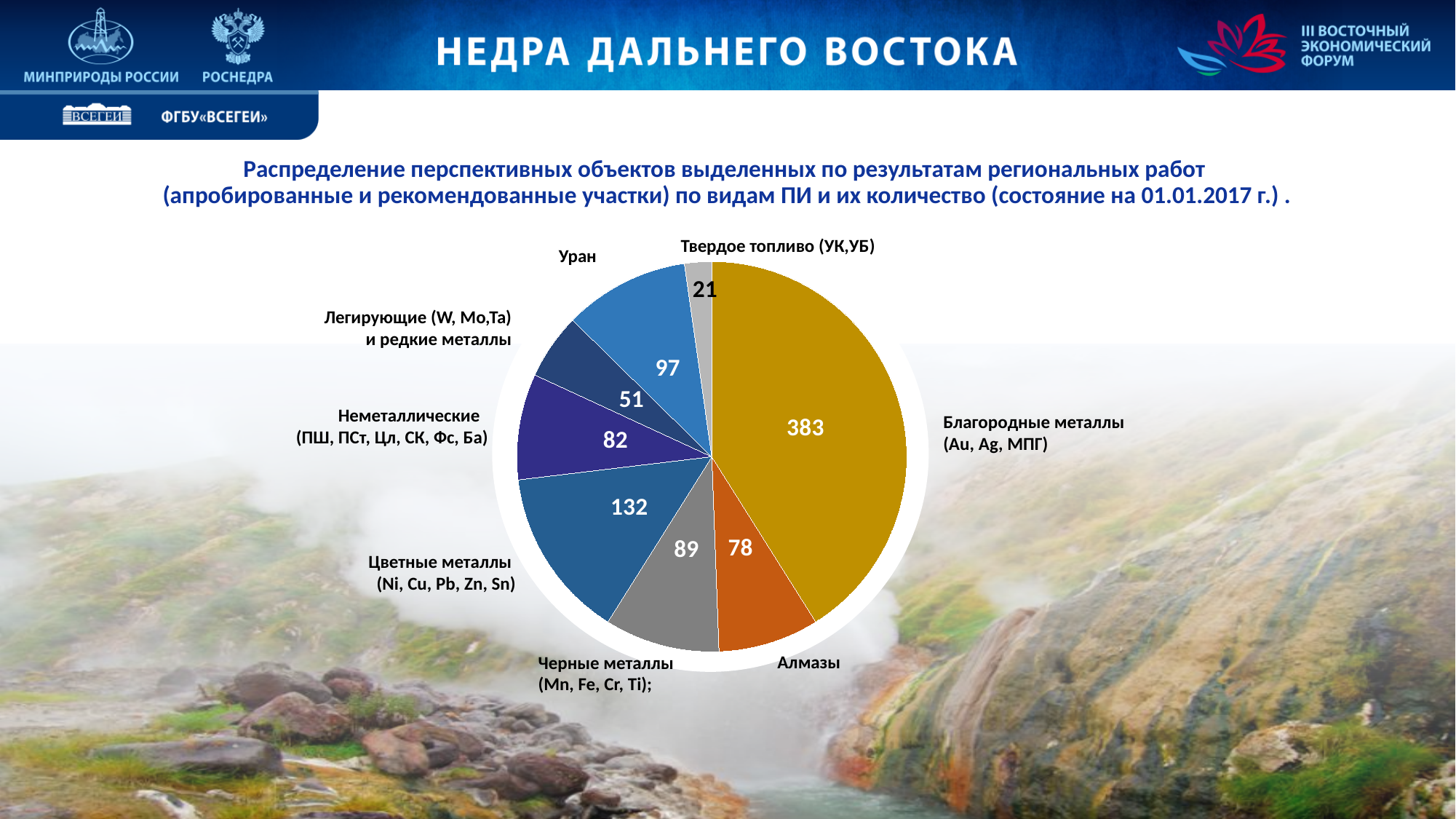
What is the value for Уран? 97 What is the value for Цветные металлы (Ni, Cu, Pb, Zn, Sn)? 132 How many slices does the pie chart have? 8 Which is larger, the value for Алмазы or the value for Неметаллические? Неметаллические What is the value for Твердое топливо (УК,УБ)? 21 What is the difference between the values for Цветные металлы and Черные металлы? 43 Which category has the smallest slice of the pie? Твердое топливо (УК,УБ) What is the title of the chart? Распределение перспективных объектов выделенных по результатам региональных работ (апробированные и рекомендованные участки) по видам ПИ и их количество (состояние на 01.01.2017 г.) What is the value for Благородные металлы (Au, Ag, МПГ)? 383 What kind of chart is shown on the slide? pie chart What is the difference between the values for Уран and Легирующие и редкие металлы? 46 Which category has the largest slice of the pie? Благородные металлы (Au, Ag, МПГ)